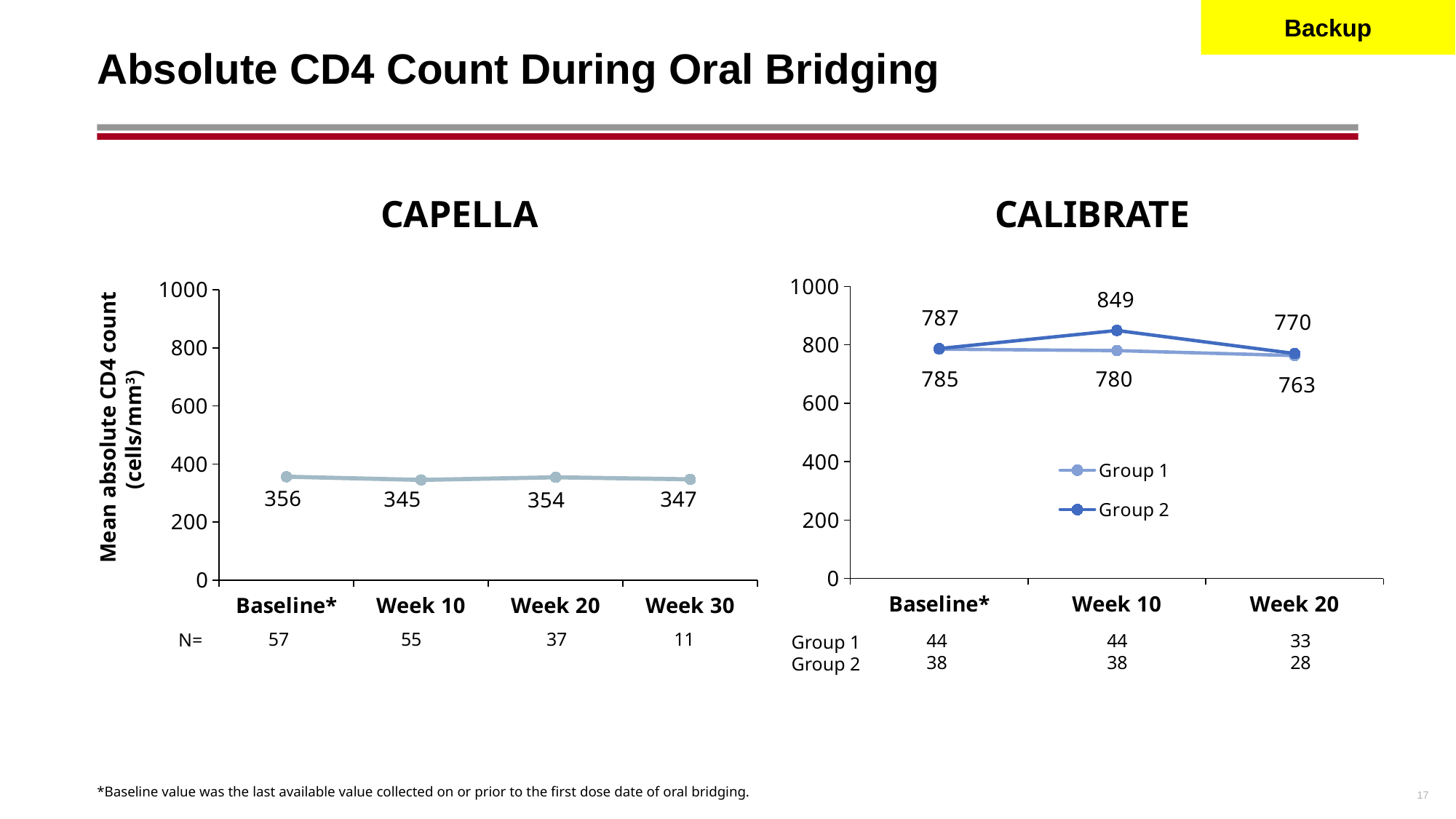
In the CALIBRATE chart, what is the Group 1 value at Week 20? 763 In the CAPELLA chart, how many time points are plotted? 4 In the CAPELLA chart, at which time point is the mean absolute CD4 count lowest? Week 10 In the CALIBRATE chart, how many series does the legend list? 2 In the CALIBRATE chart, at which time point does Group 2 reach its highest value? Week 10 In the CALIBRATE chart, what is the difference between Group 2 and Group 1 at Week 10? 69 In the CAPELLA chart, what is the mean absolute CD4 count at Week 30? 347 In the CAPELLA chart, what is the difference between the Baseline* value and the Week 10 value? 11 In the CAPELLA chart, what is the mean absolute CD4 count at Baseline*? 356 What type of chart is the CAPELLA chart? Line chart In the CALIBRATE chart, what is the Group 2 value at Week 10? 849 In the CALIBRATE chart, which group has the larger value at Week 10? Group 2